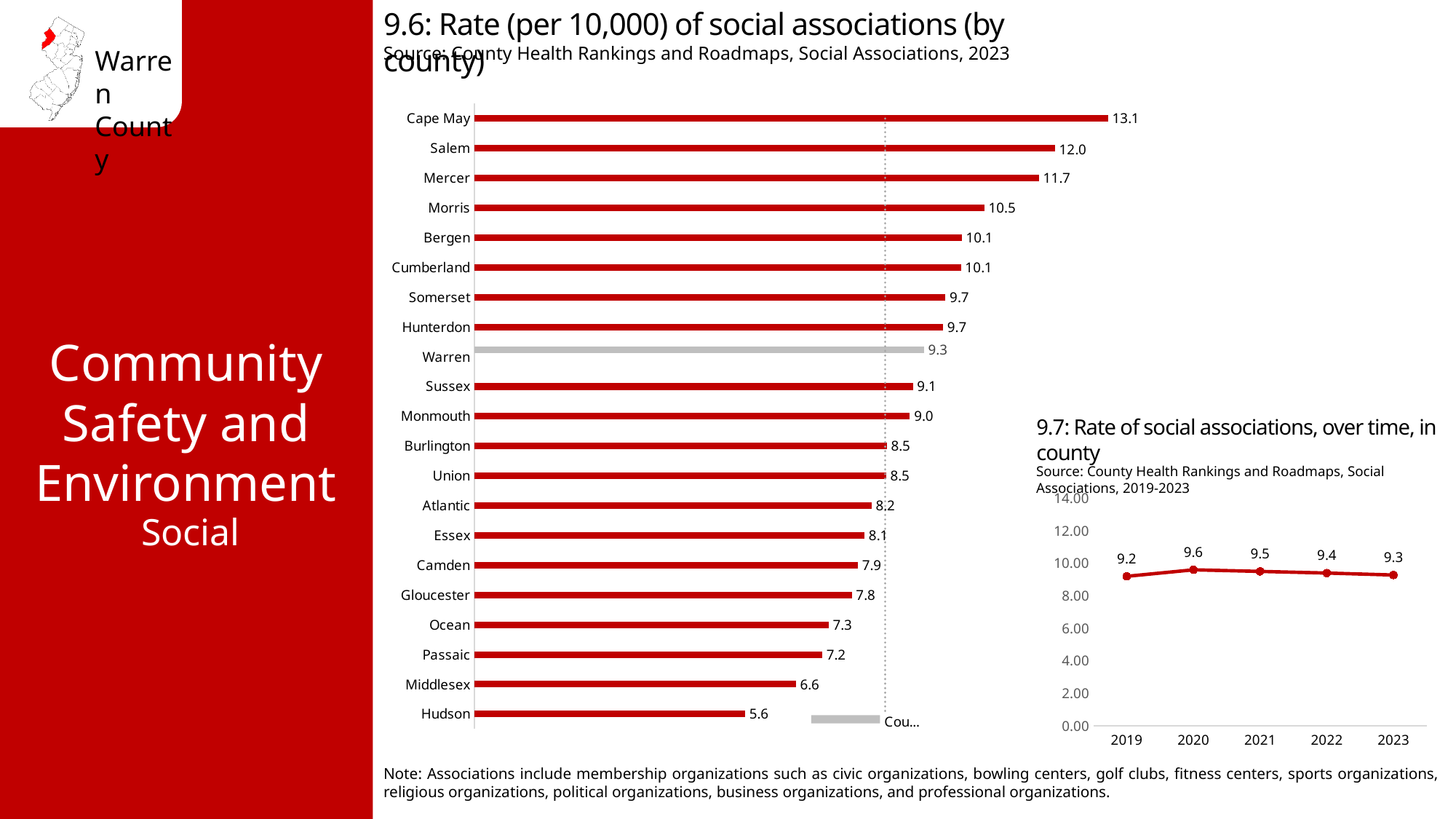
In chart 9.6 (rate of social associations by county), what is the value for Warren? 9.3 In chart 9.6 (rate of social associations by county), how many counties are shown? 21 In chart 9.7 (rate of social associations over time), what is the value for 2020? 9.6 In chart 9.6 (rate of social associations by county), what is the value for Middlesex? 6.6 In chart 9.7 (rate of social associations over time), do the values rise or fall from 2020 to 2023? Fall In chart 9.6 (rate of social associations by county), which county has the highest rate? Cape May In chart 9.6 (rate of social associations by county), what is the difference between Cape May and Hudson? 7.5 In chart 9.7 (rate of social associations over time), which year has the lowest value? 2019 In chart 9.6 (rate of social associations by county), which is larger, the value for Morris or the value for Sussex? Morris In chart 9.6 (rate of social associations by county), which county has the lowest rate? Hudson What kind of chart is chart 9.6 (rate of social associations by county)? Bar chart In chart 9.7 (rate of social associations over time), how many years are plotted? 5